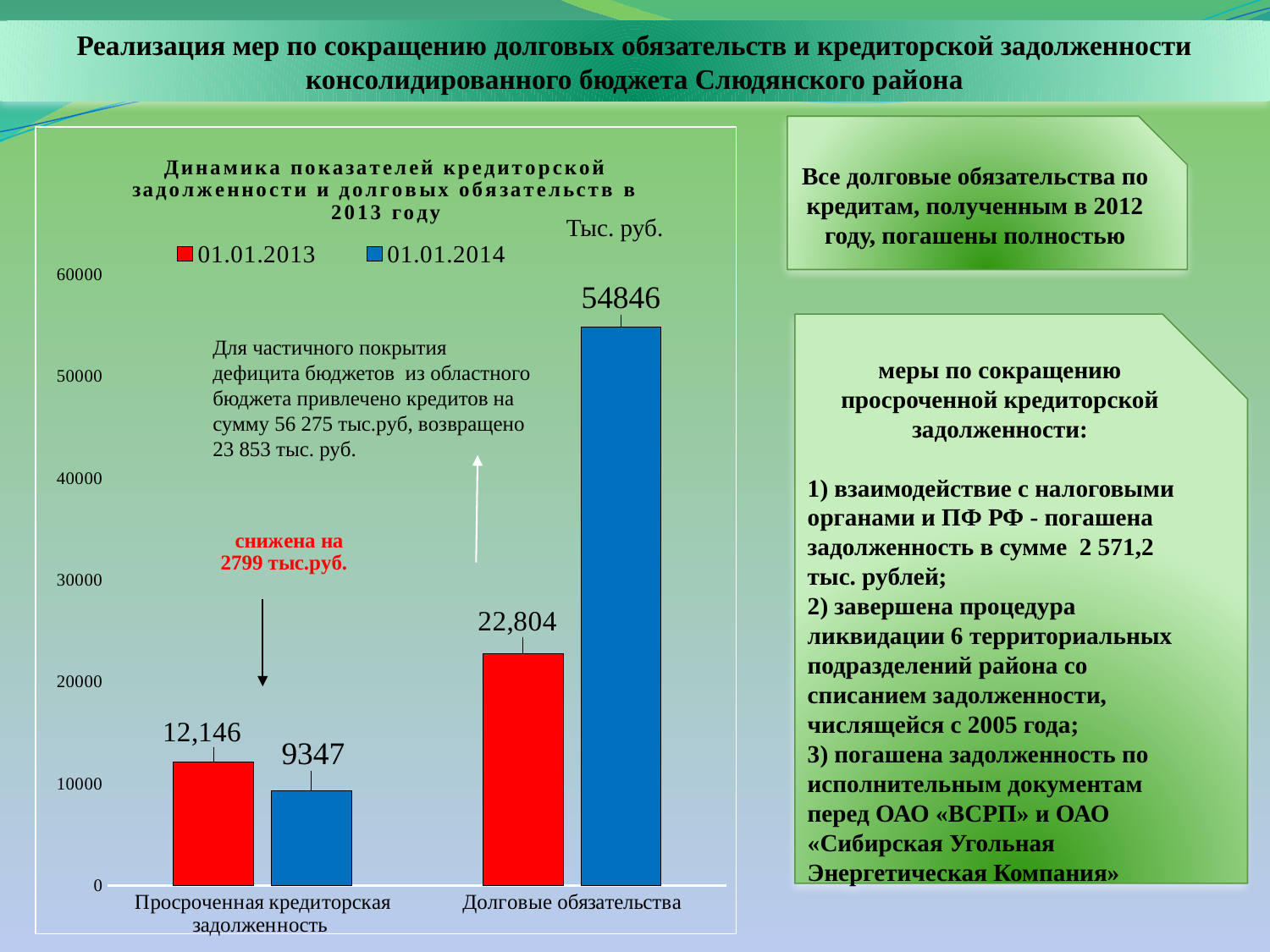
For Долговые обязательства, which series has the larger value, 01.01.2013 or 01.01.2014? 01.01.2014 How many series does the chart legend list? 2 Which bar in the chart has the highest value? Долговые обязательства, 01.01.2014 What is the difference between the 01.01.2014 and 01.01.2013 values for Долговые обязательства? 32042 What is the value for Просроченная кредиторская задолженность in the 01.01.2013 series? 12,146 What is the value for Просроченная кредиторская задолженность in the 01.01.2014 series? 9347 By how much did Просроченная кредиторская задолженность decrease from 01.01.2013 to 01.01.2014? 2799 What is the value for Долговые обязательства in the 01.01.2013 series? 22,804 What is the value for Долговые обязательства in the 01.01.2014 series? 54846 What type of chart is shown on the slide? Bar chart How many categories are shown on the x axis of the chart? 2 Which bar in the chart has the lowest value? Просроченная кредиторская задолженность, 01.01.2014